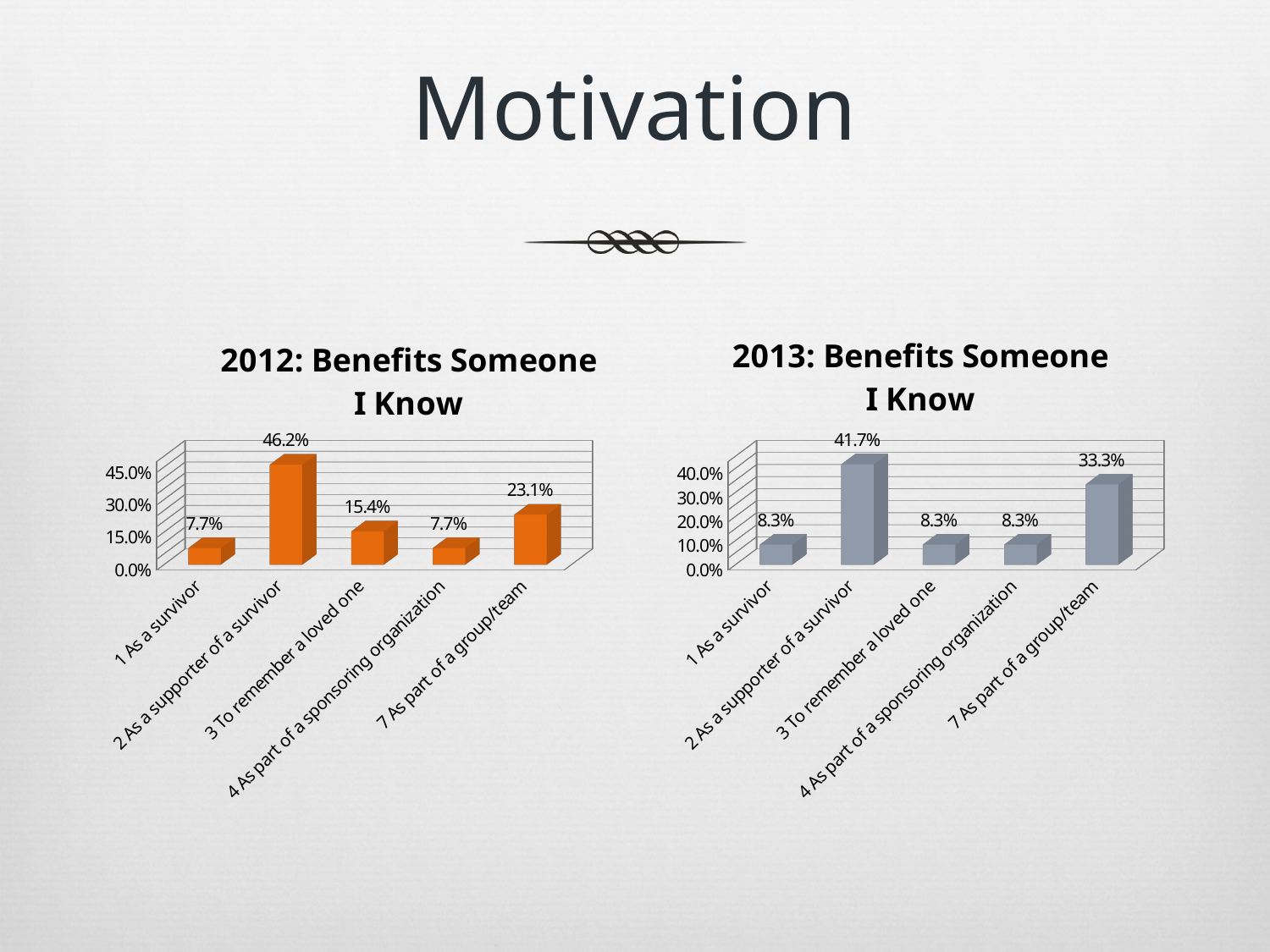
In the '2013: Benefits Someone I Know' chart, what is the value for '7 As part of a group/team'? 33.3% In the '2012: Benefits Someone I Know' chart, what is the value for '3 To remember a loved one'? 15.4% In the '2012: Benefits Someone I Know' chart, which category has the highest value? 2 As a supporter of a survivor What colour are the bars in the '2013: Benefits Someone I Know' chart? Grey In the '2012: Benefits Someone I Know' chart, which is larger: the value for '3 To remember a loved one' or '7 As part of a group/team'? 7 As part of a group/team What kind of chart is the '2012: Benefits Someone I Know' chart? Bar chart In the '2013: Benefits Someone I Know' chart, which category has the highest value? 2 As a supporter of a survivor In the '2012: Benefits Someone I Know' chart, what is the difference between the values for '2 As a supporter of a survivor' and '7 As part of a group/team'? 23.1% How many categories are shown in the '2013: Benefits Someone I Know' chart? 5 In the '2013: Benefits Someone I Know' chart, what is the difference between the values for '2 As a supporter of a survivor' and '7 As part of a group/team'? 8.4% In the '2013: Benefits Someone I Know' chart, is the value for '2 As a supporter of a survivor' greater or less than 40.0%? greater In the '2012: Benefits Someone I Know' chart, what is the value for '2 As a supporter of a survivor'? 46.2%